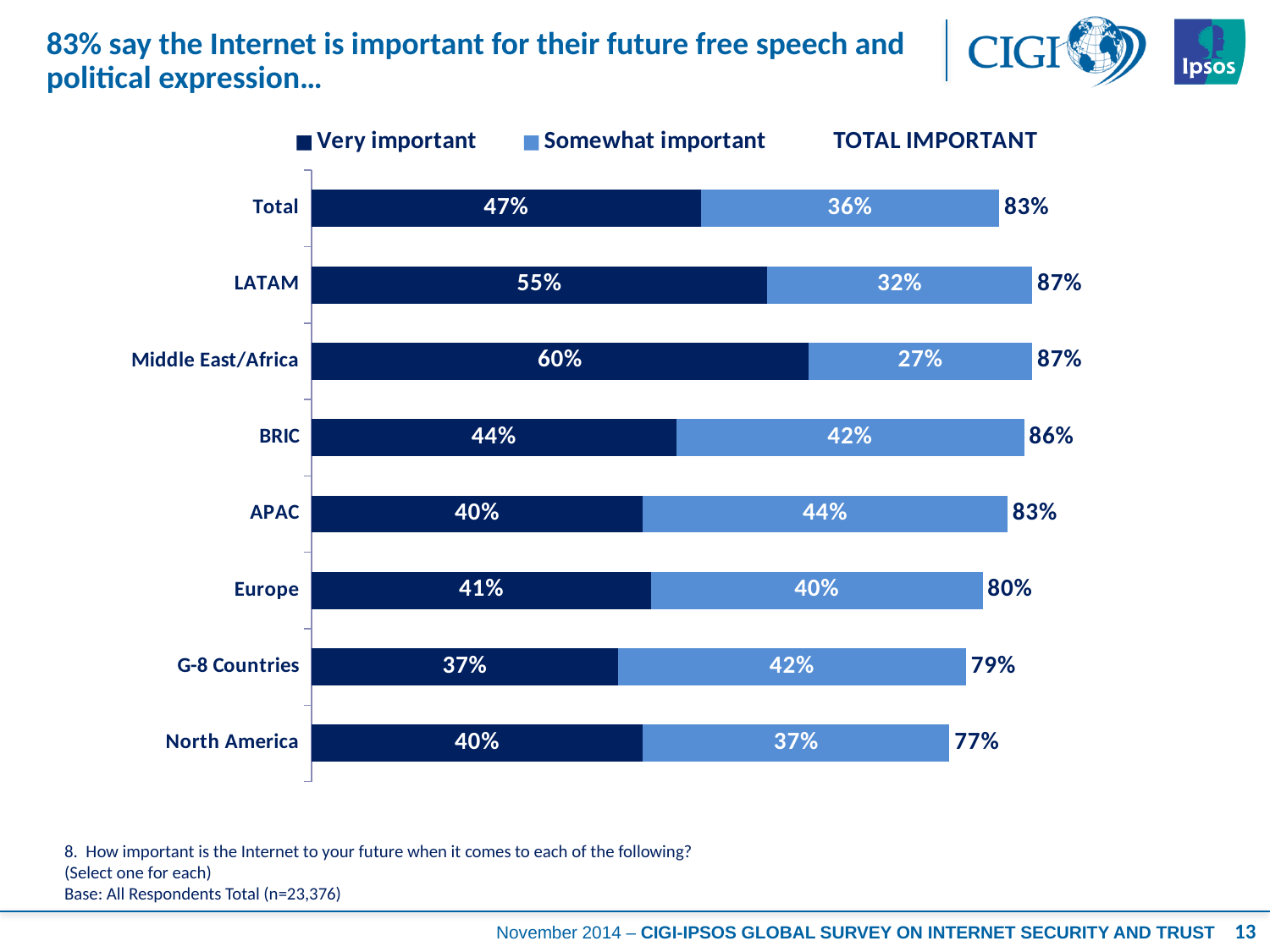
What is the 'Somewhat important' value for BRIC? 42% Which region has the highest 'Very important' percentage? Middle East/Africa Which region has the lowest TOTAL IMPORTANT percentage? North America What is the total of the stacked bar for Europe? 80% What kind of chart is shown on the slide? Stacked bar chart Which colour represents 'Very important' in the chart? Dark blue What is the TOTAL IMPORTANT value for North America? 77% How many regions or groups are shown on the chart, including Total? 8 What is the difference between the 'Very important' values for Middle East/Africa and G-8 Countries? 23% Which is larger, the 'Somewhat important' value for APAC or for Europe? APAC What percentage of respondents in LATAM say the Internet is very important for their future free speech and political expression? 55% How many series does the legend list? 3